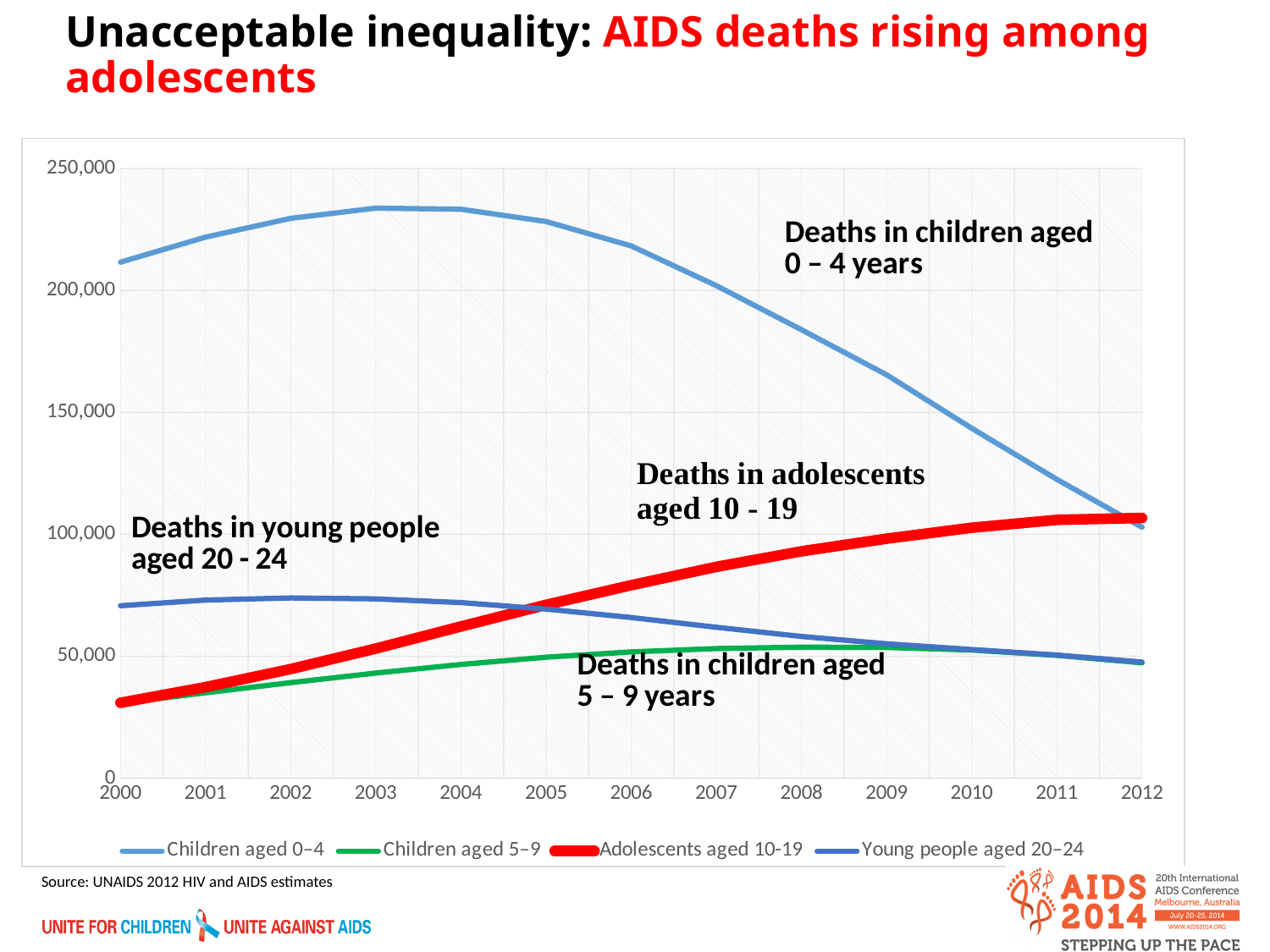
Is the value for children aged 0-4 in 2003 greater or less than 200,000? greater Which series has the highest value in 2000? Children aged 0-4 Is the value for adolescents aged 10-19 in 2012 greater or less than 100,000? greater In 2008, which is larger: deaths in adolescents aged 10-19 or deaths in children aged 5-9? Adolescents aged 10-19 Do deaths in children aged 0-4 rise or fall from 2004 to 2012? Fall How many years are shown along the x axis? 13 In 2012, which is larger: deaths in adolescents aged 10-19 or deaths in young people aged 20-24? Adolescents aged 10-19 What kind of chart is shown on the slide? Line chart Is the value for children aged 5-9 in 2000 greater or less than 50,000? less What colour is the line for adolescents aged 10-19? Red How many series does the legend list? 4 Do deaths in adolescents aged 10-19 rise or fall from 2000 to 2012? Rise